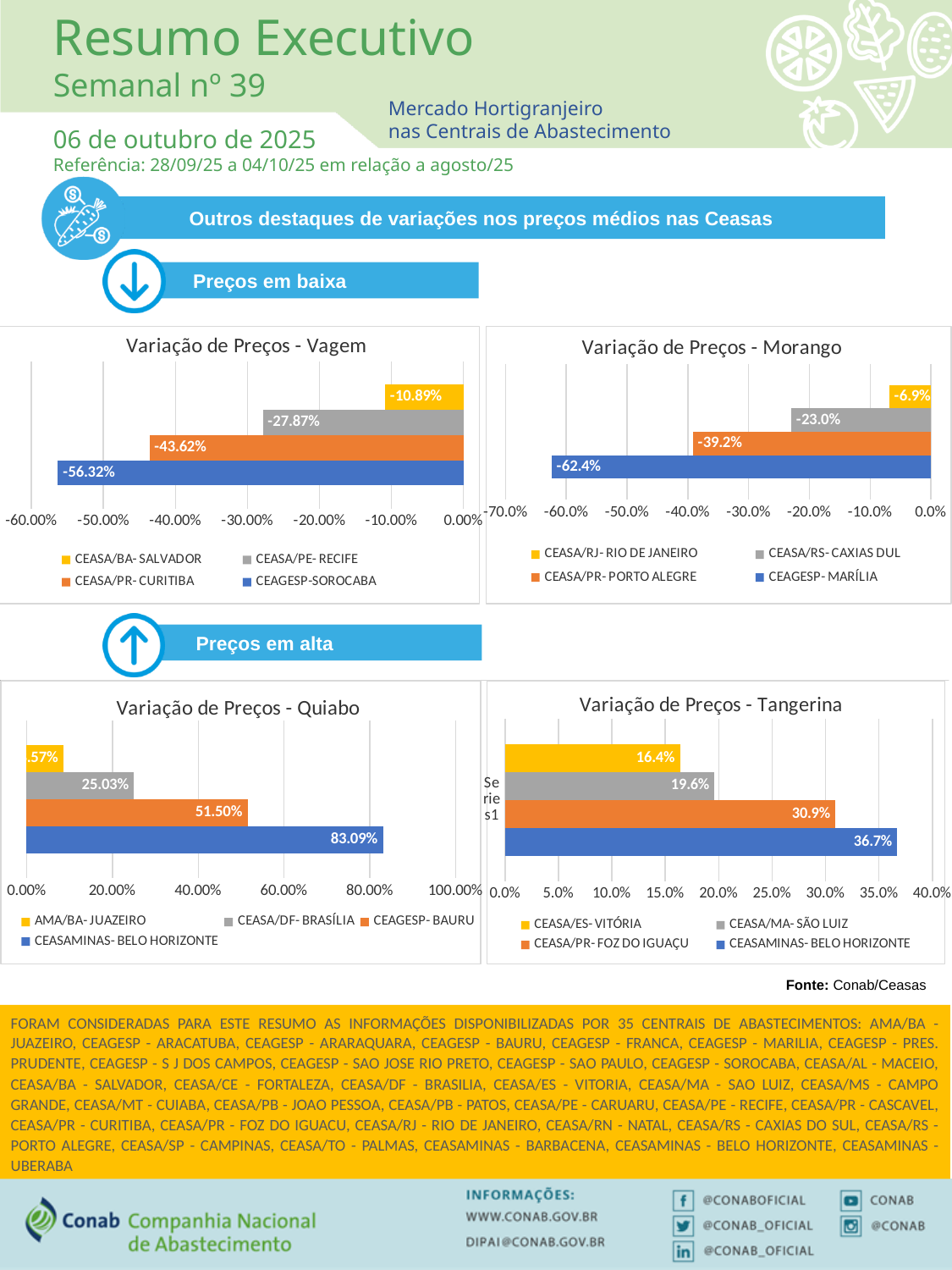
In the 'Variação de Preços - Tangerina' chart, what is the value for CEASA/PR- FOZ DO IGUAÇU? 30.9% In the 'Variação de Preços - Morango' chart, what is the value for CEAGESP- MARÍLIA? -62.4% In the 'Variação de Preços - Quiabo' chart, which series has the highest value? CEASAMINAS- BELO HORIZONTE In the 'Variação de Preços - Vagem' chart, what is the value for CEAGESP-SOROCABA? -56.32% In the 'Variação de Preços - Vagem' chart, which series has the smallest decline (value closest to zero)? CEASA/BA- SALVADOR In the 'Variação de Preços - Quiabo' chart, what is the value for CEASAMINAS- BELO HORIZONTE? 83.09% In the 'Variação de Preços - Morango' chart, how many series does the legend list? 4 In the 'Variação de Preços - Vagem' chart, what is the value for CEASA/PE- RECIFE? -27.87% What kind of chart is 'Variação de Preços - Tangerina'? Bar chart In the 'Variação de Preços - Tangerina' chart, which is larger: the value for CEASA/ES- VITÓRIA or CEASA/MA- SÃO LUIZ? CEASA/MA- SÃO LUIZ In the 'Variação de Preços - Quiabo' chart, is the value for CEAGESP- BAURU greater or less than 40.00%? greater In the 'Variação de Preços - Morango' chart, what is the difference between the values for CEASA/PR- PORTO ALEGRE and CEASA/RS- CAXIAS DUL? 16.2 percentage points